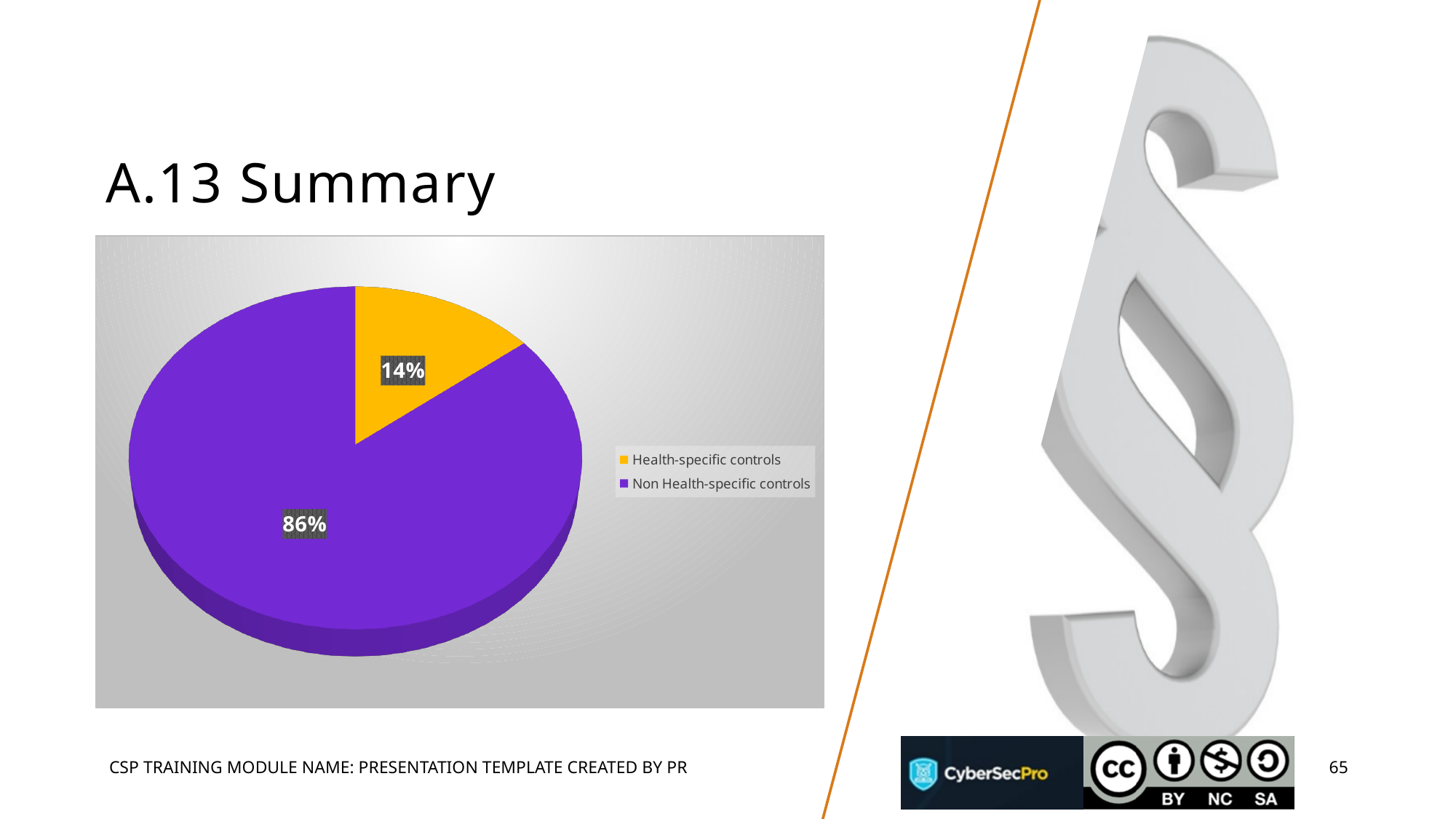
How many slices does the pie chart have? 2 What is the difference in percentage points between the Non Health-specific controls slice and the Health-specific controls slice? 72 How many entries does the legend list? 2 What share of the pie is labelled for Health-specific controls? 14% What is the total of the two percentages shown on the pie chart? 100% Which slice is larger: Health-specific controls or Non Health-specific controls? Non Health-specific controls What colour is the Non Health-specific controls slice? Purple What share of the pie is labelled for Non Health-specific controls? 86% What colour is the Health-specific controls slice? Yellow Which category has the smallest slice of the pie? Health-specific controls What kind of chart is shown on the slide? Pie chart Which category has the largest slice of the pie? Non Health-specific controls